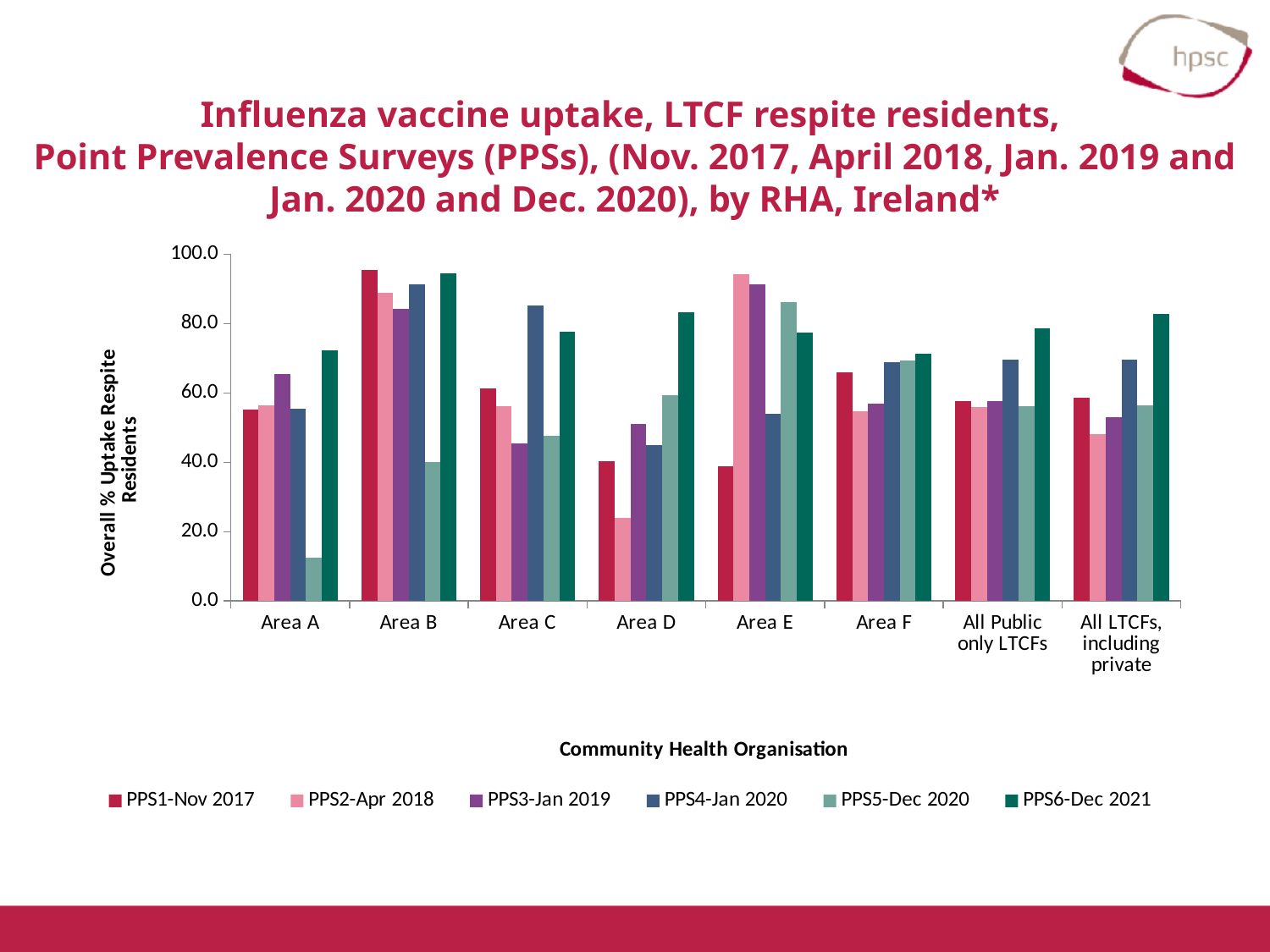
What kind of chart is shown on the slide? Bar chart Is the value for PPS1-Nov 2017 in Area B greater or less than 80.0? greater Is the value for PPS5-Dec 2020 in Area A greater or less than 20.0? less How many categories are shown along the x axis? 8 Which survey has the highest value in Area D? PPS6-Dec 2021 Is the value for PPS2-Apr 2018 in Area D greater or less than 40.0? less Which survey has the lowest value in Area A? PPS5-Dec 2020 In Area E, which is larger: the value for PPS1-Nov 2017 or PPS2-Apr 2018? PPS2-Apr 2018 What is the title of the y axis? Overall % Uptake Respite Residents Which area has the lowest value for PPS5-Dec 2020? Area A How many series does the legend list? 6